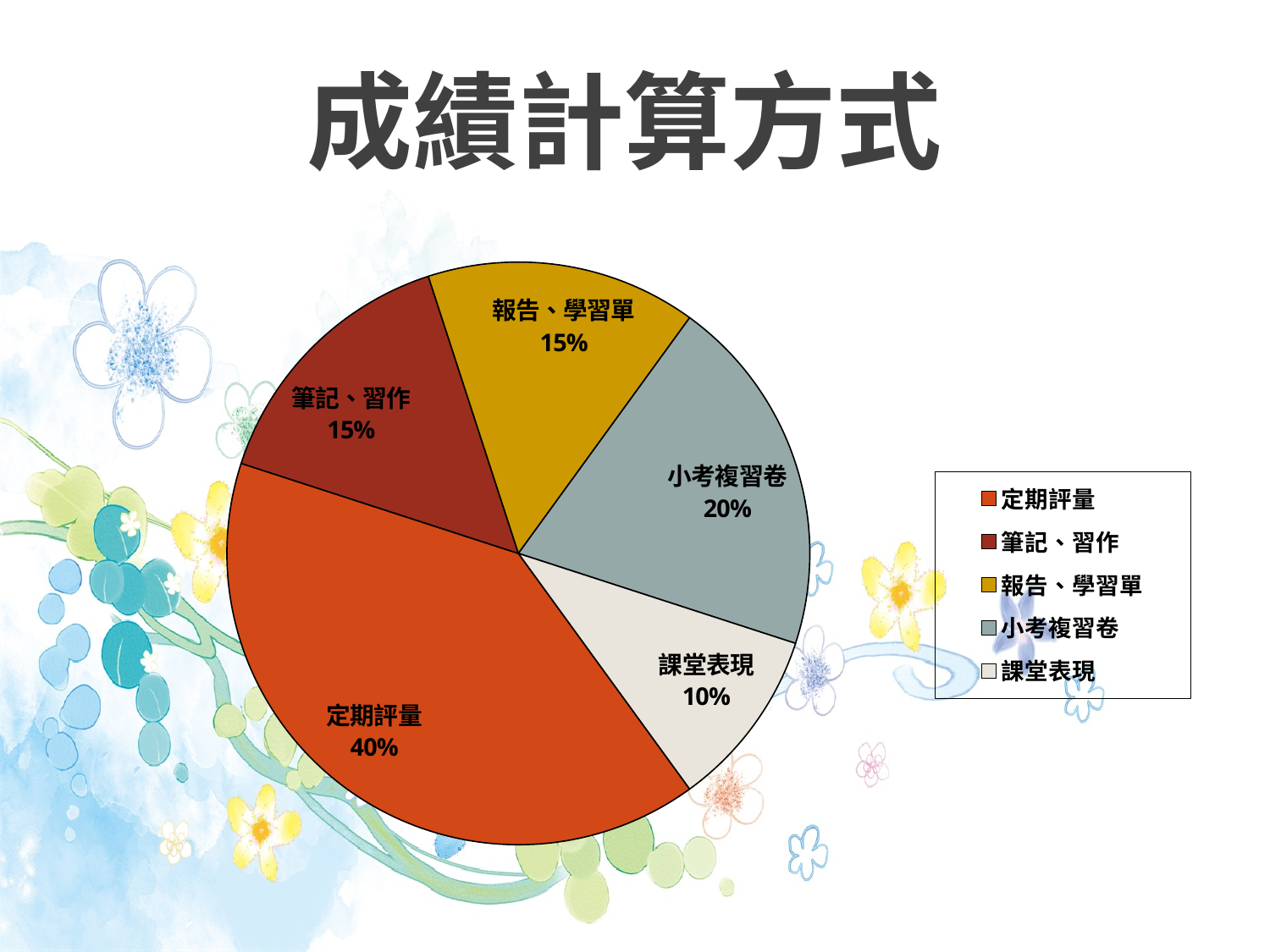
What is the value shown for 課堂表現? 10% What is the value shown for 筆記、習作? 15% Which category has the largest slice of the pie? 定期評量 What share of the pie does 定期評量 take? 40% How many slices does the pie chart have? 5 Which category has the smallest slice of the pie? 課堂表現 What is the title of the slide containing the chart? 成績計算方式 What is the value shown for 小考複習卷? 20% Which is larger, the share for 小考複習卷 or the share for 報告、學習單? 小考複習卷 What kind of chart is shown on the slide? pie chart How many entries does the legend list? 5 What is the difference between the shares of 定期評量 and 小考複習卷? 20%